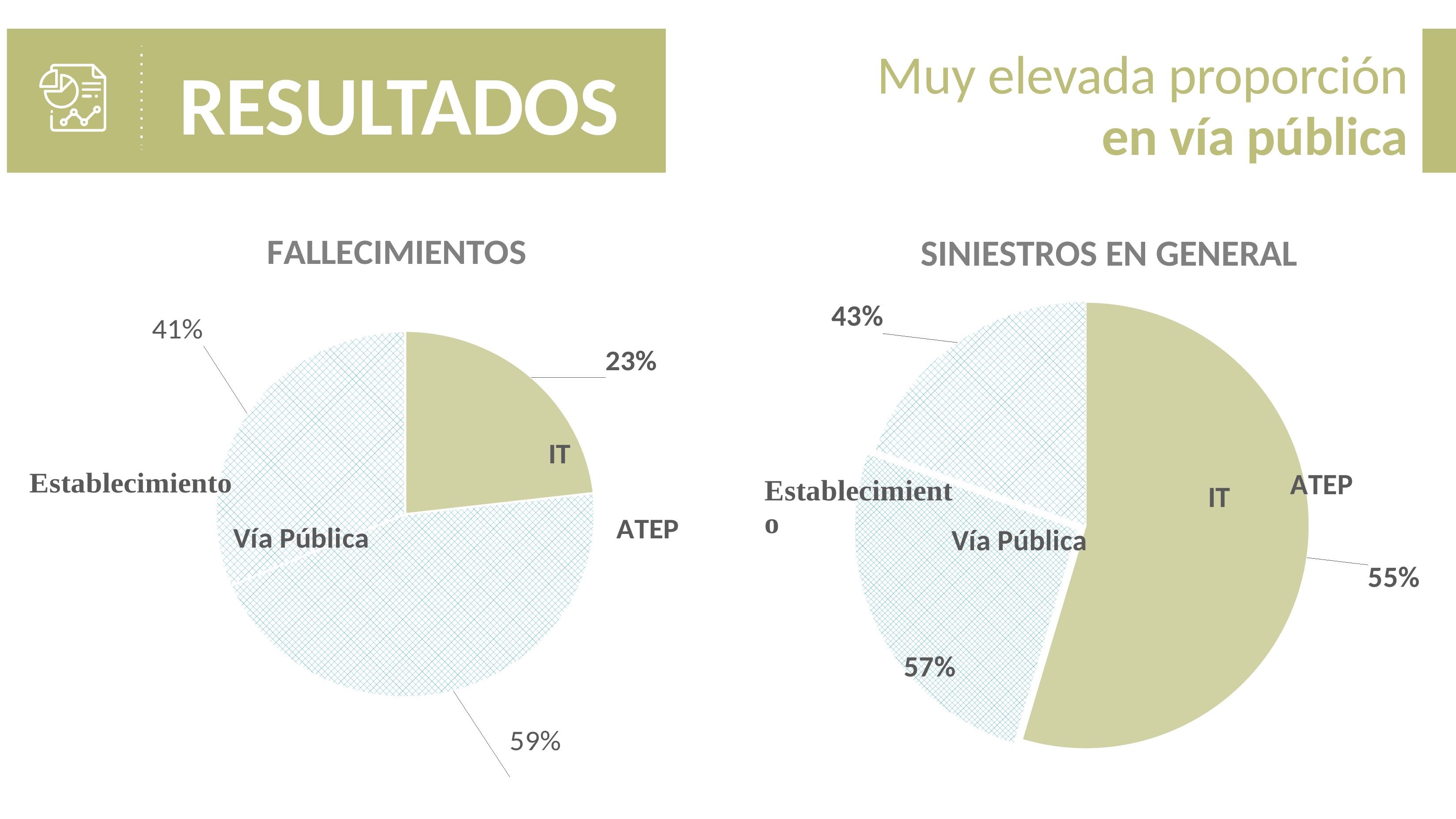
What is the title of the chart on the right side of the slide? SINIESTROS EN GENERAL In the FALLECIMIENTOS chart, what percentage is shown for Vía Pública? 59% In the SINIESTROS EN GENERAL chart, what percentage is shown for Vía Pública? 57% In the FALLECIMIENTOS chart, what percentage is shown for Establecimiento? 41% What kind of chart is the FALLECIMIENTOS chart? Pie chart In the SINIESTROS EN GENERAL chart, what percentage is shown for Establecimiento? 43% How many charts are shown on the slide? 2 In the FALLECIMIENTOS chart, which is larger, Vía Pública or Establecimiento? Vía Pública In the SINIESTROS EN GENERAL chart, which is larger, Vía Pública or Establecimiento? Vía Pública In the SINIESTROS EN GENERAL chart, which is larger, IT or Establecimiento? IT In the FALLECIMIENTOS chart, what percentage is shown for IT? 23% In the SINIESTROS EN GENERAL chart, what percentage is shown for IT? 55%